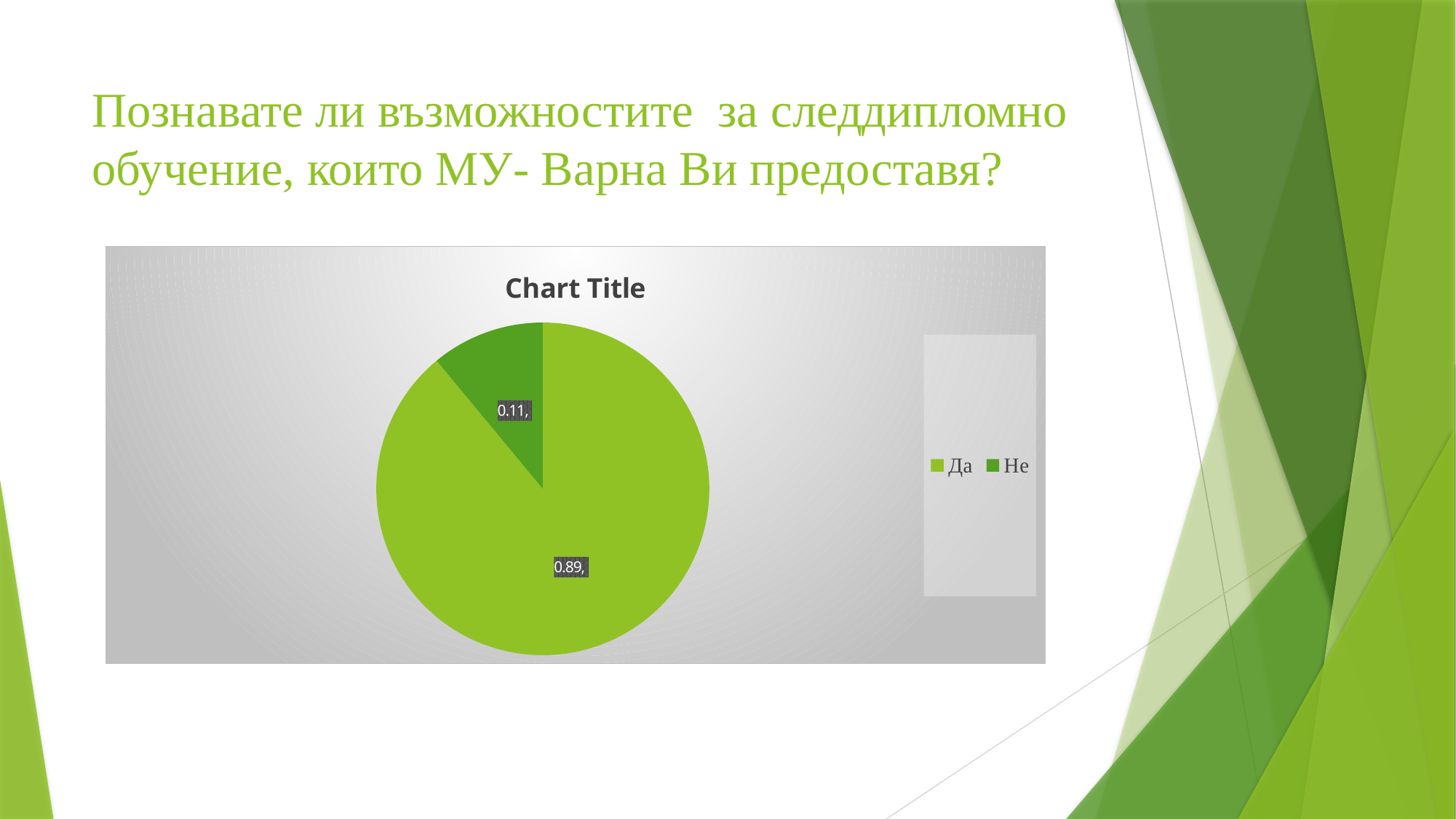
How many entries does the legend list? 2 How many slices does the pie chart have? 2 Which slice is the largest? Да Which legend entries are listed for the pie chart? Да and Не What is the title shown above the pie chart? Chart Title What is the value shown for the Да slice? 0.89 Which is larger, the Да slice or the Не slice? Да What is the difference between the Да value and the Не value? 0.78 What kind of chart is shown on the slide? pie chart Which slice is the smallest? Не What is the value shown for the Не slice? 0.11